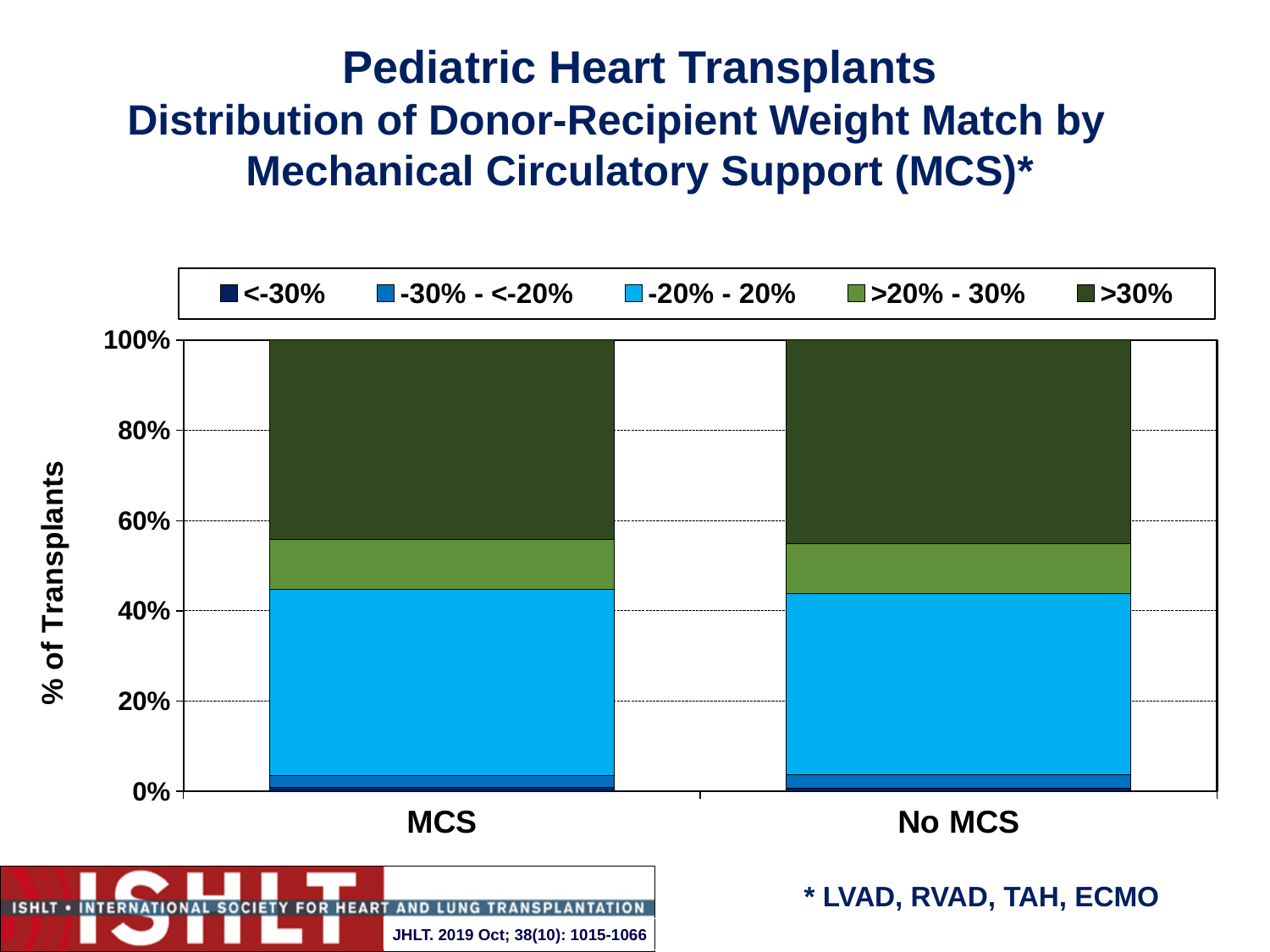
For the MCS bar, which segment is larger: >30% or >20% - 30%? >30% Is the share of the >30% weight-match group for MCS greater or less than 40%? greater What kind of chart is shown on the slide? Stacked bar chart Is the share of the <-30% weight-match group for No MCS greater or less than 20%? less What is the label of the y axis of the chart? % of Transplants How many series does the chart's legend list? 5 Is the share of the >30% weight-match group for No MCS greater or less than 40%? greater How many categories are shown on the x axis of the chart? 2 What value does each stacked bar in the chart total? 100% What are the two categories on the x axis of the chart? MCS and No MCS For the No MCS bar, which segment is larger: -20% - 20% or -30% - <-20%? -20% - 20%